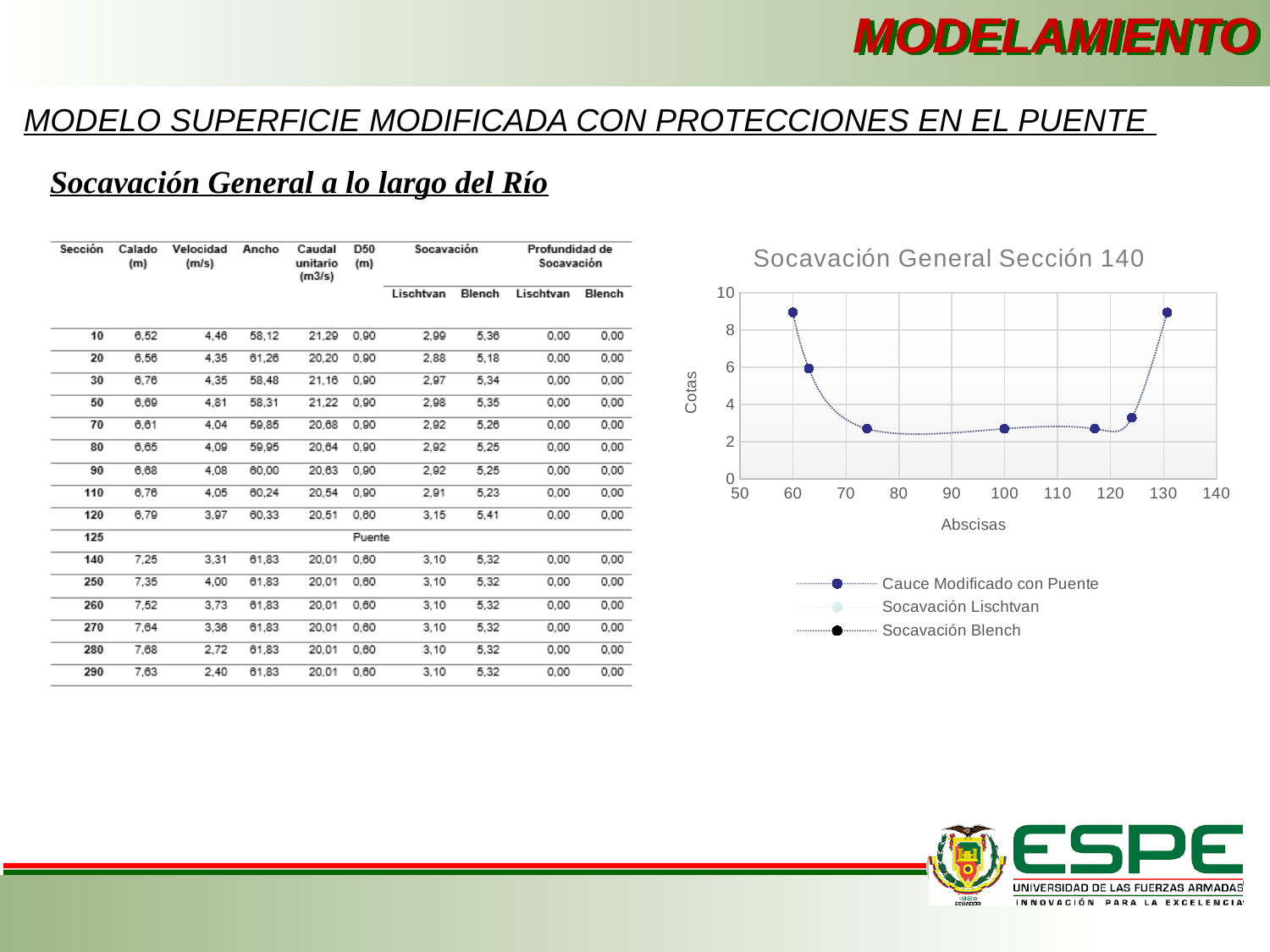
Is the value (Cotas) of the point near abscissa 75 greater or less than 4? less Do the Cotas values rise or fall as the abscissa increases from 120 to 130? rise How many data points are plotted on the chart? 7 What kind of chart is shown on the slide? line chart Is the value (Cotas) of the point near abscissa 130 greater or less than 8? greater Which point has the larger Cotas value: the one at abscissa 60 or the one at abscissa 100? the one at abscissa 60 How many series does the chart legend list? 3 What is the label of the vertical axis of the chart? Cotas Is the value (Cotas) of the point at abscissa 100 greater or less than 4? less Do the Cotas values rise or fall as the abscissa increases from 60 to 100? fall What is the title of the chart on the slide? Socavación General Sección 140